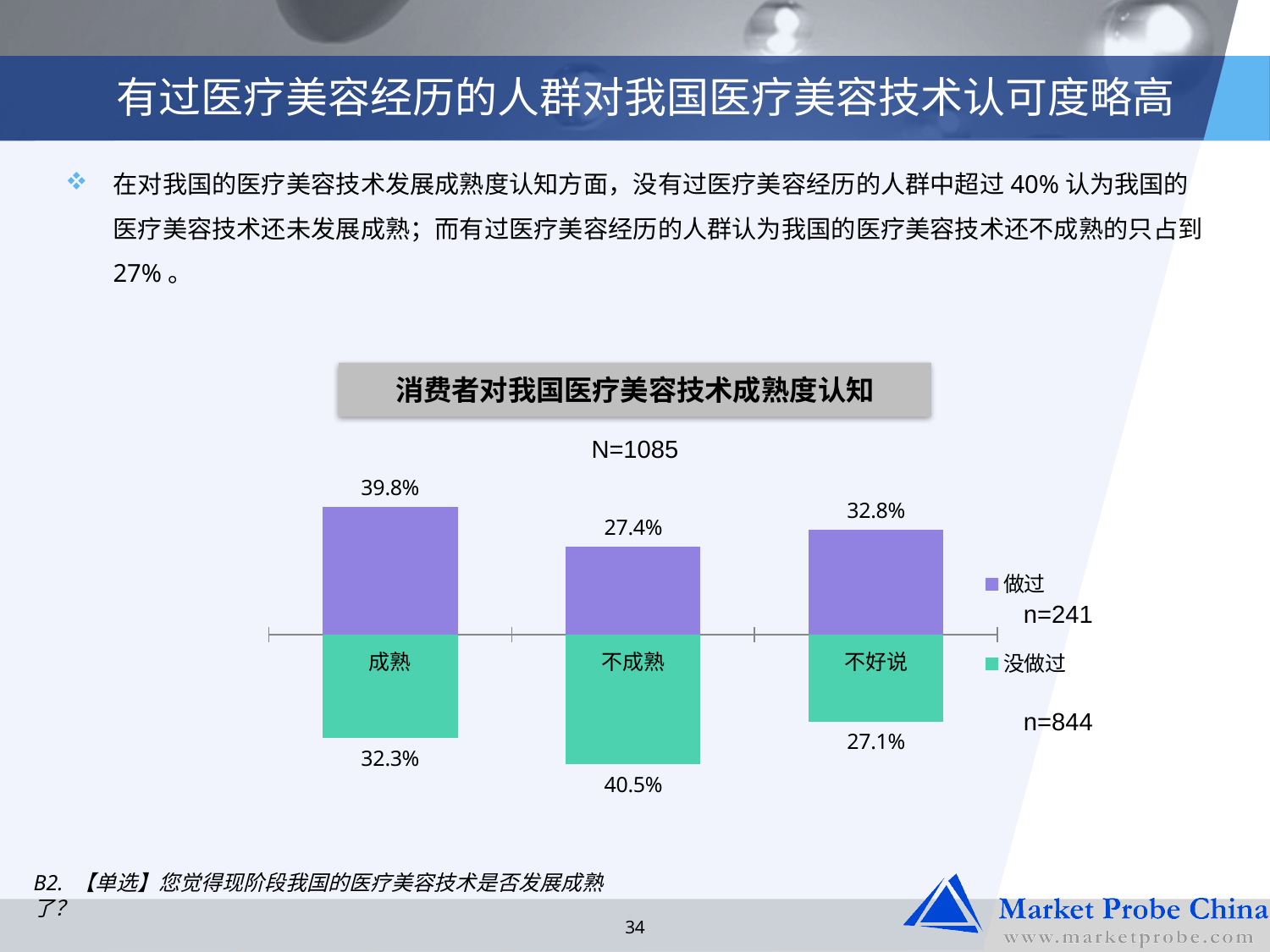
What is the value for 不好说 in the 没做过 series? 27.1% What kind of chart is shown on the slide? bar chart Which category has the highest value in the 做过 series? 成熟 How many categories are shown on the chart? 3 What is the value for 不成熟 in the 没做过 series? 40.5% Which category has the lowest value in the 没做过 series? 不好说 What is the difference between the 没做过 and 做过 values for 不成熟? 13.1% How many series does the legend list? 2 For 成熟, which series has the larger value, 做过 or 没做过? 做过 What is the title of the chart? 消费者对我国医疗美容技术成熟度认知 What is the value for 不好说 in the 做过 series? 32.8% What is the value for 成熟 in the 做过 series? 39.8%